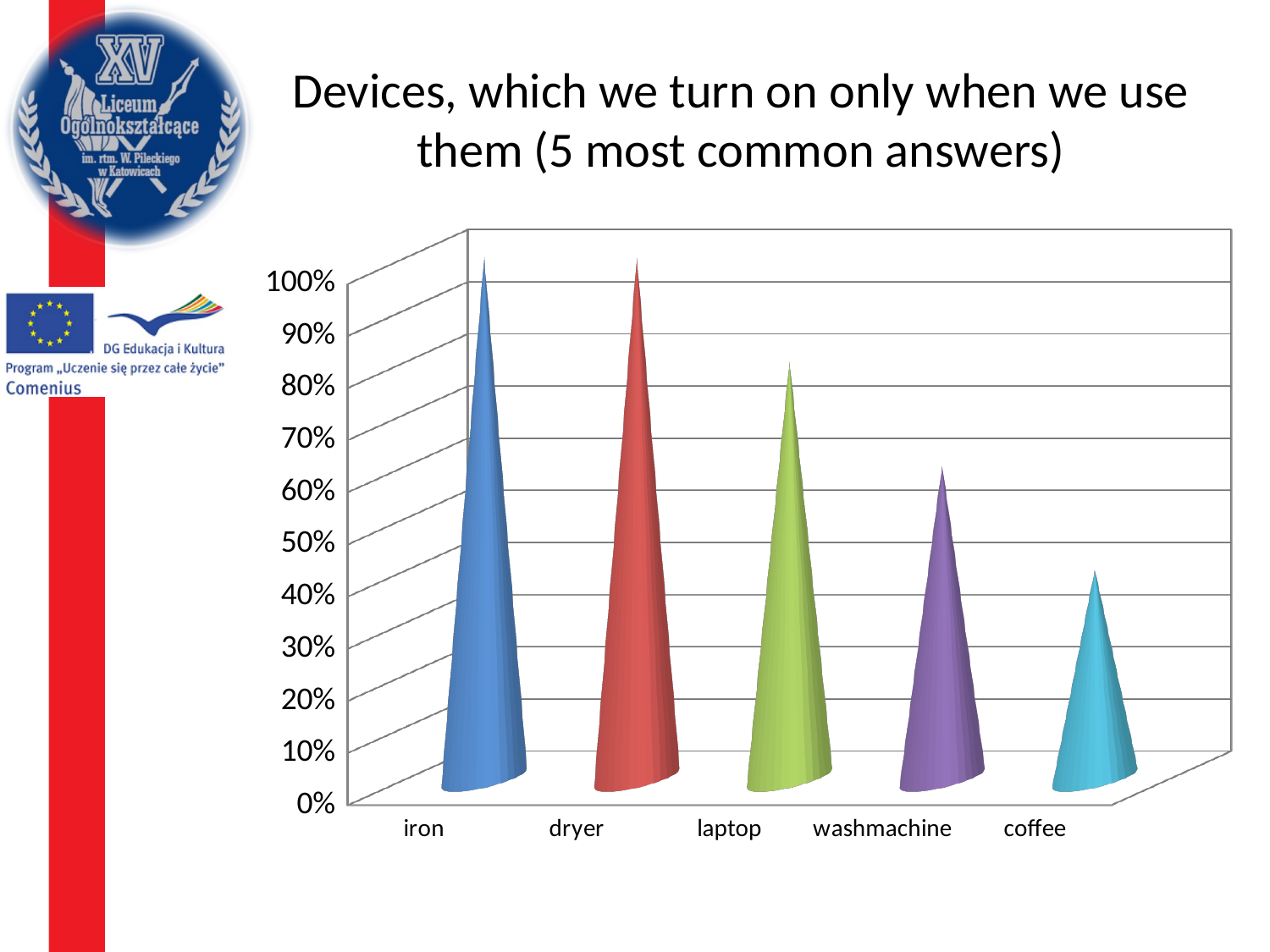
Which is larger, the value for laptop or the value for coffee? laptop Is the value for laptop greater or less than 50%? greater Do the values rise or fall from left to right along the x axis? fall Which is larger, the value for dryer or the value for washmachine? dryer Is the value for coffee greater or less than 60%? less Is the value for coffee greater or less than 20%? greater What kind of chart is shown on the slide? bar chart How many device categories are shown on the x axis? 5 Which device has the lowest value? coffee What is the title of the chart? Devices, which we turn on only when we use them (5 most common answers)